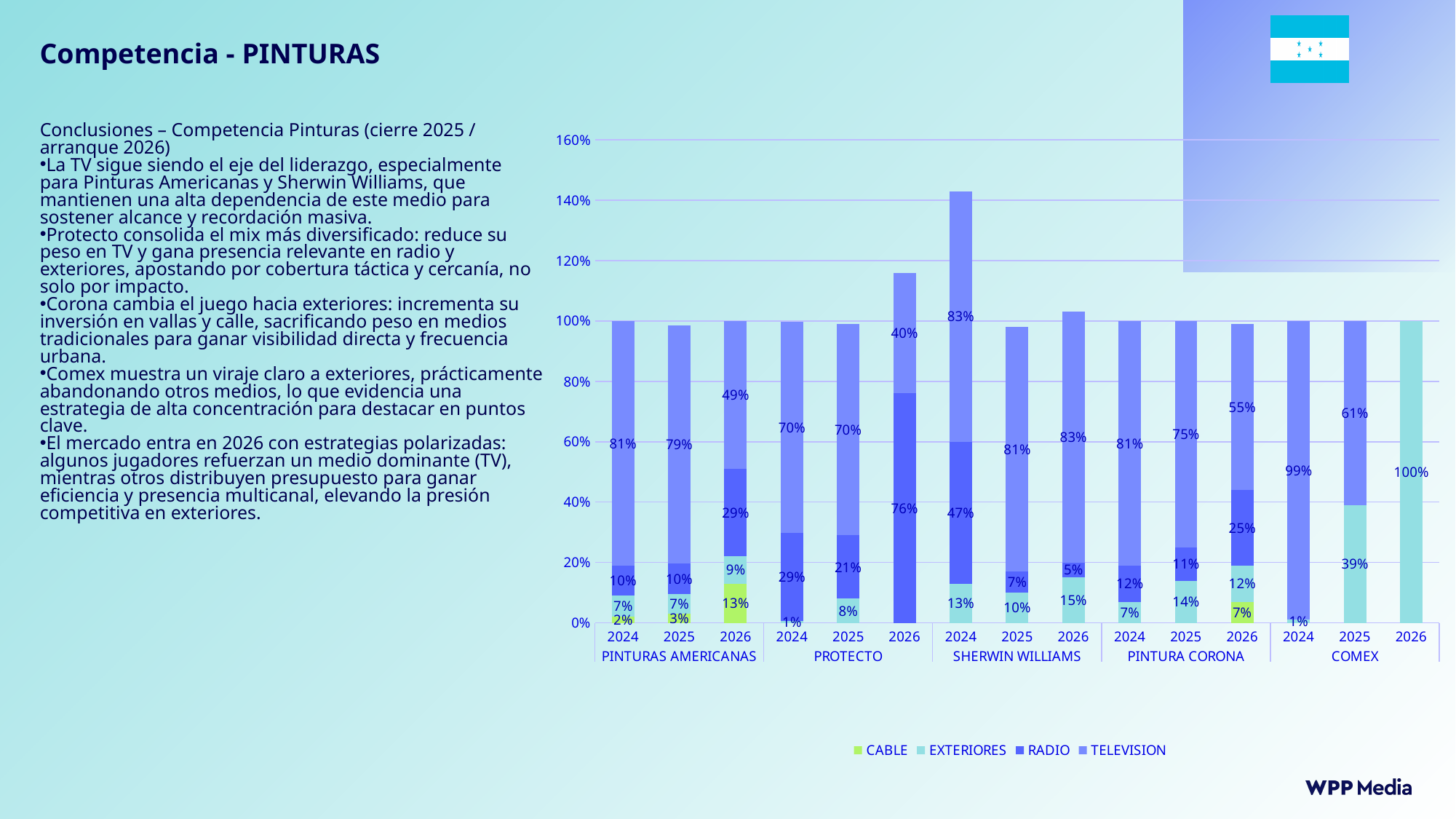
How many brands are shown along the x axis of the chart? 5 Does the EXTERIORES share for COMEX rise or fall from 2024 to 2026? Rise Which brand-year bar is the tallest in the chart? SHERWIN WILLIAMS 2024 What is the total of the stacked bar for SHERWIN WILLIAMS in 2024? 143% How many series does the chart legend list? 4 What is the RADIO share for PROTECTO in 2026? 76% Which is larger: the EXTERIORES share for COMEX in 2025 or for PINTURA CORONA in 2025? COMEX 2025 What is the CABLE share for PINTURAS AMERICANAS in 2026? 13% What is the difference between the TELEVISION share for PINTURAS AMERICANAS in 2024 and in 2026? 32 percentage points What is the EXTERIORES share for COMEX in 2025? 39% What is the TELEVISION share for PINTURAS AMERICANAS in 2024? 81% What kind of chart is shown on the slide? Stacked bar chart